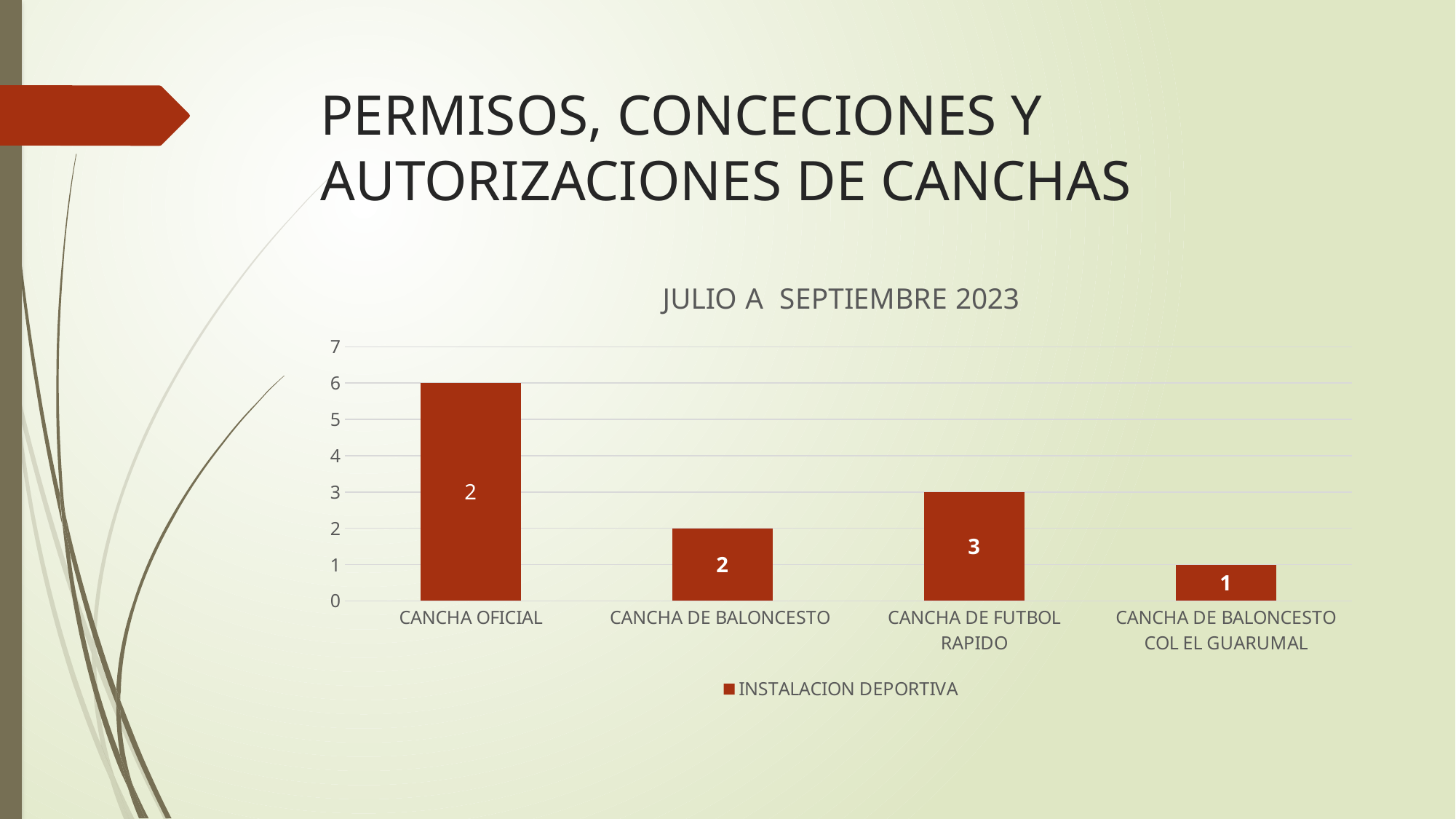
What series name is shown in the legend? INSTALACION DEPORTIVA What is the value for CANCHA DE BALONCESTO COL EL GUARUMAL? 1 Which is larger, the value for CANCHA DE FUTBOL RAPIDO or the value for CANCHA DE BALONCESTO COL EL GUARUMAL? CANCHA DE FUTBOL RAPIDO What kind of chart is shown on the slide? bar chart Is the value for CANCHA DE FUTBOL RAPIDO greater or less than 2? greater How many categories are shown on the x axis? 4 What is the title of the chart? JULIO A SEPTIEMBRE 2023 What is the value for CANCHA DE FUTBOL RAPIDO? 3 Which category has the lowest value? CANCHA DE BALONCESTO COL EL GUARUMAL How many series does the legend list? 1 What is the value for CANCHA DE BALONCESTO? 2 What is the difference between the values for CANCHA DE FUTBOL RAPIDO and CANCHA DE BALONCESTO? 1